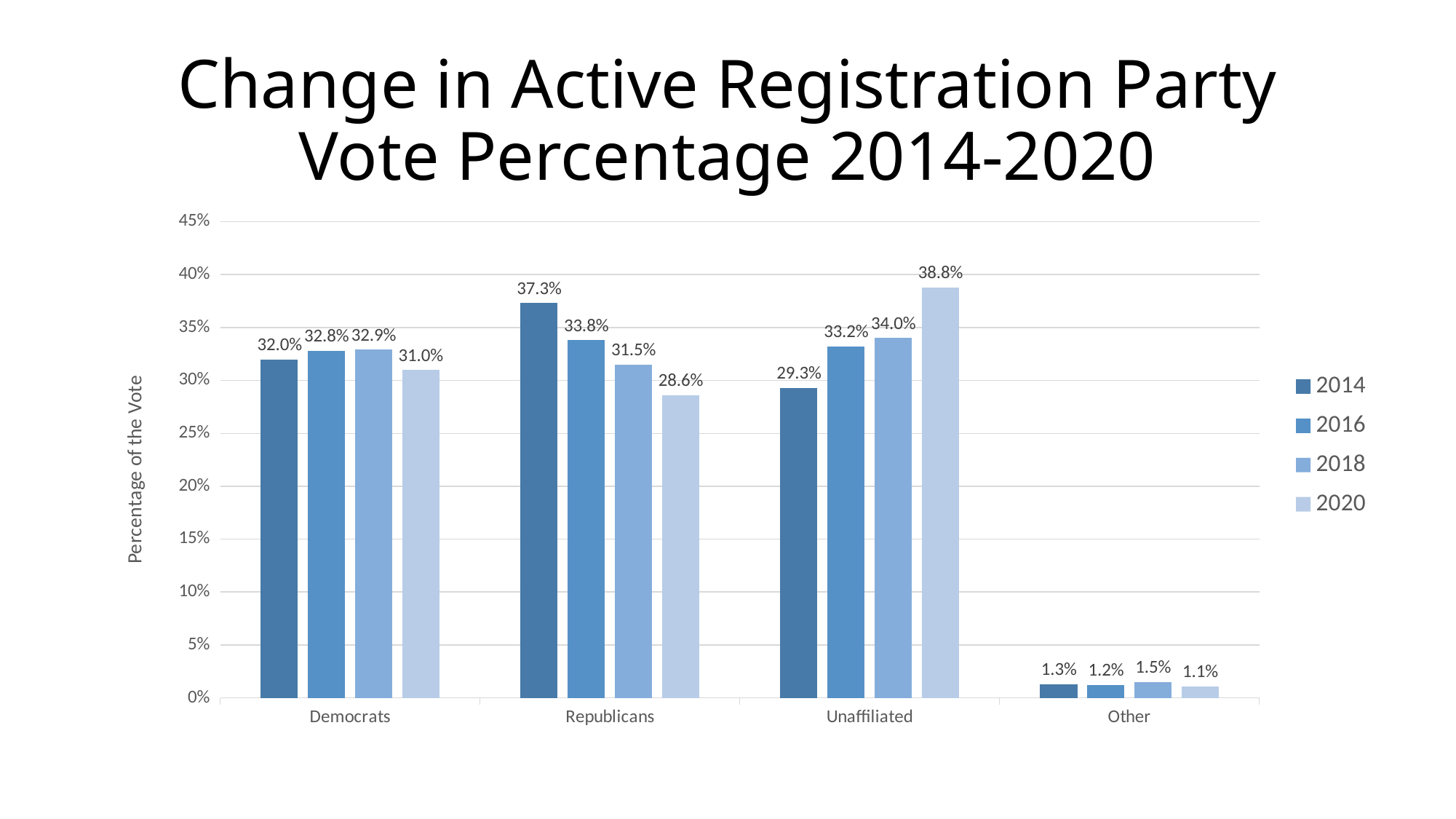
How many series does the legend list? 4 What is the difference between the Republicans value in 2014 and in 2020? 8.7% How many categories are shown on the x axis? 4 What is the value for Republicans in 2014? 37.3% What is the value for Unaffiliated in 2020? 38.8% What kind of chart is shown on the slide? Bar chart Do the Republicans values rise or fall from 2014 to 2020? Fall Which category has the highest value in 2020? Unaffiliated Which is larger, the Democrats value in 2016 or the Unaffiliated value in 2016? Unaffiliated value in 2016 What is the value for Other in 2016? 1.2% What is the value for Democrats in 2018? 32.9% Which category has the lowest value in 2014? Other